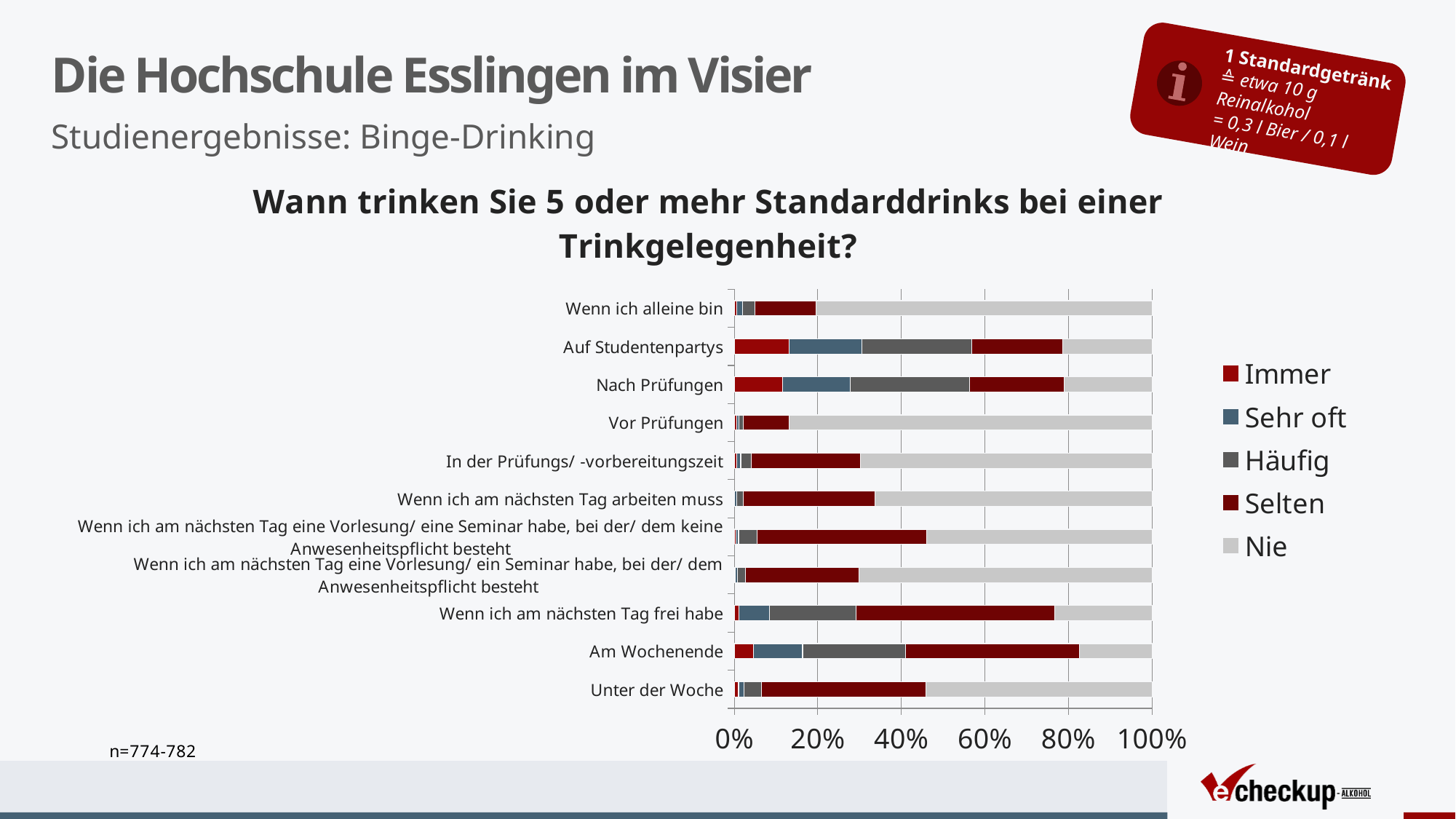
How many categories (drinking occasions) are listed on the chart's vertical axis? 11 What kind of chart is shown on the slide? Stacked bar chart Is the 'Nie' share for 'Wenn ich am nächsten Tag arbeiten muss' greater or less than 60%? greater Is the 'Nie' share for 'Unter der Woche' greater or less than 60%? less Is the 'Immer' share for 'Am Wochenende' greater or less than 20%? less Which has the larger 'Nie' share: 'Vor Prüfungen' or 'Am Wochenende'? Vor Prüfungen What are the legend entries of the chart, from top to bottom? Immer, Sehr oft, Häufig, Selten, Nie How many series does the chart's legend list? 5 Which category has the largest 'Nie' share? Vor Prüfungen What is the title of the chart? Wann trinken Sie 5 oder mehr Standarddrinks bei einer Trinkgelegenheit? Which has the larger 'Selten' share: 'Auf Studentenpartys' or 'Wenn ich alleine bin'? Auf Studentenpartys